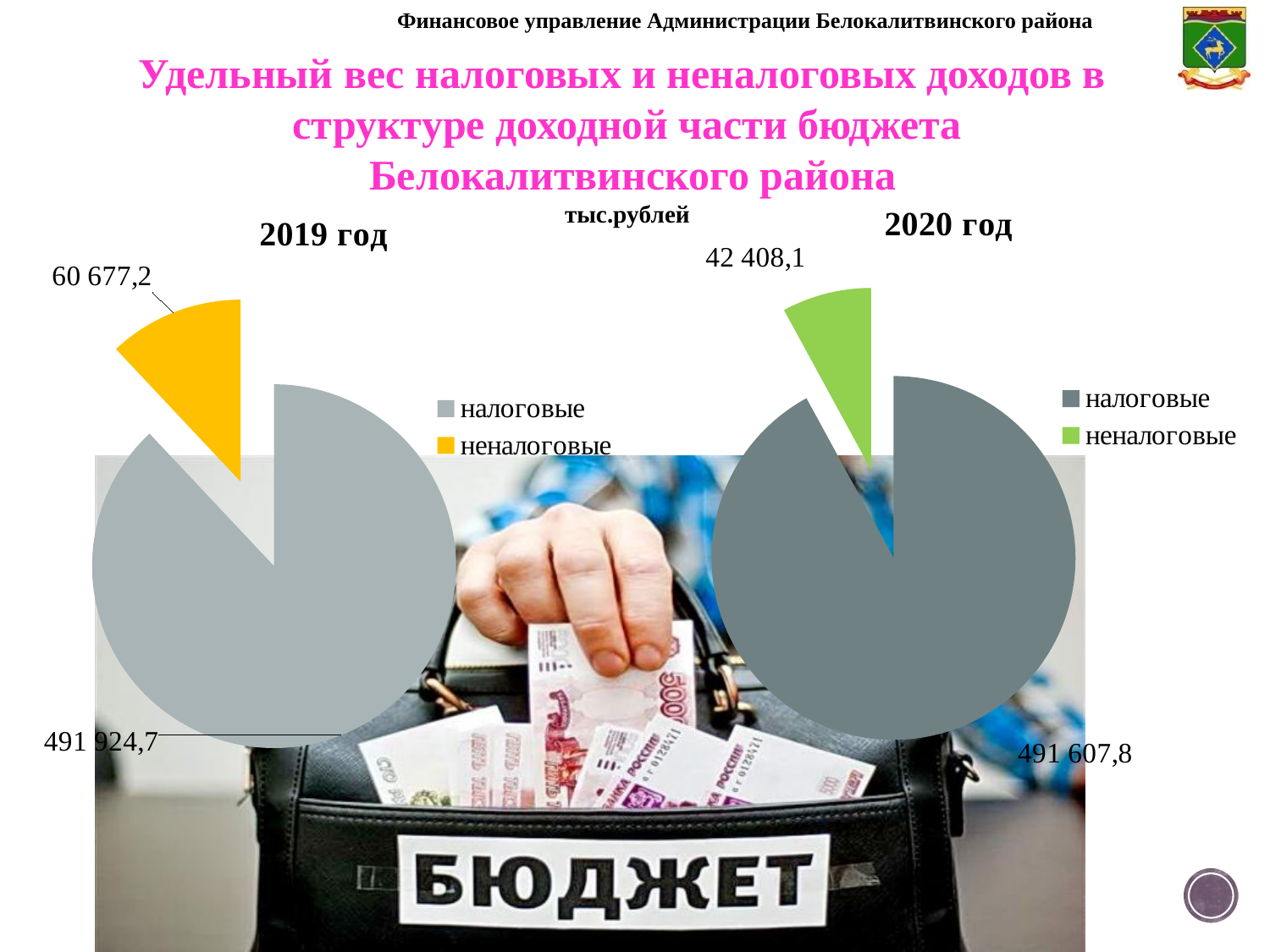
In the 2020 год pie chart, what is the value for налоговые? 491 607,8 How many categories does the 2020 год pie chart show? 2 What unit is stated for the values in the charts? тыс.рублей In the 2019 год pie chart, what is the value for налоговые? 491 924,7 In the 2019 год pie chart, what is the difference between налоговые and неналоговые? 431 247,5 Is the value for неналоговые larger in the 2019 год chart or the 2020 год chart? 2019 год In the 2020 год pie chart, what is the value for неналоговые? 42 408,1 In the 2020 год pie chart, what is the difference between налоговые and неналоговые? 449 199,7 What type of chart is used for 2019 год? pie chart In the 2019 год pie chart, which category has the largest slice? налоговые In the 2019 год pie chart, what is the value for неналоговые? 60 677,2 In the 2020 год pie chart, which category has the smallest slice? неналоговые